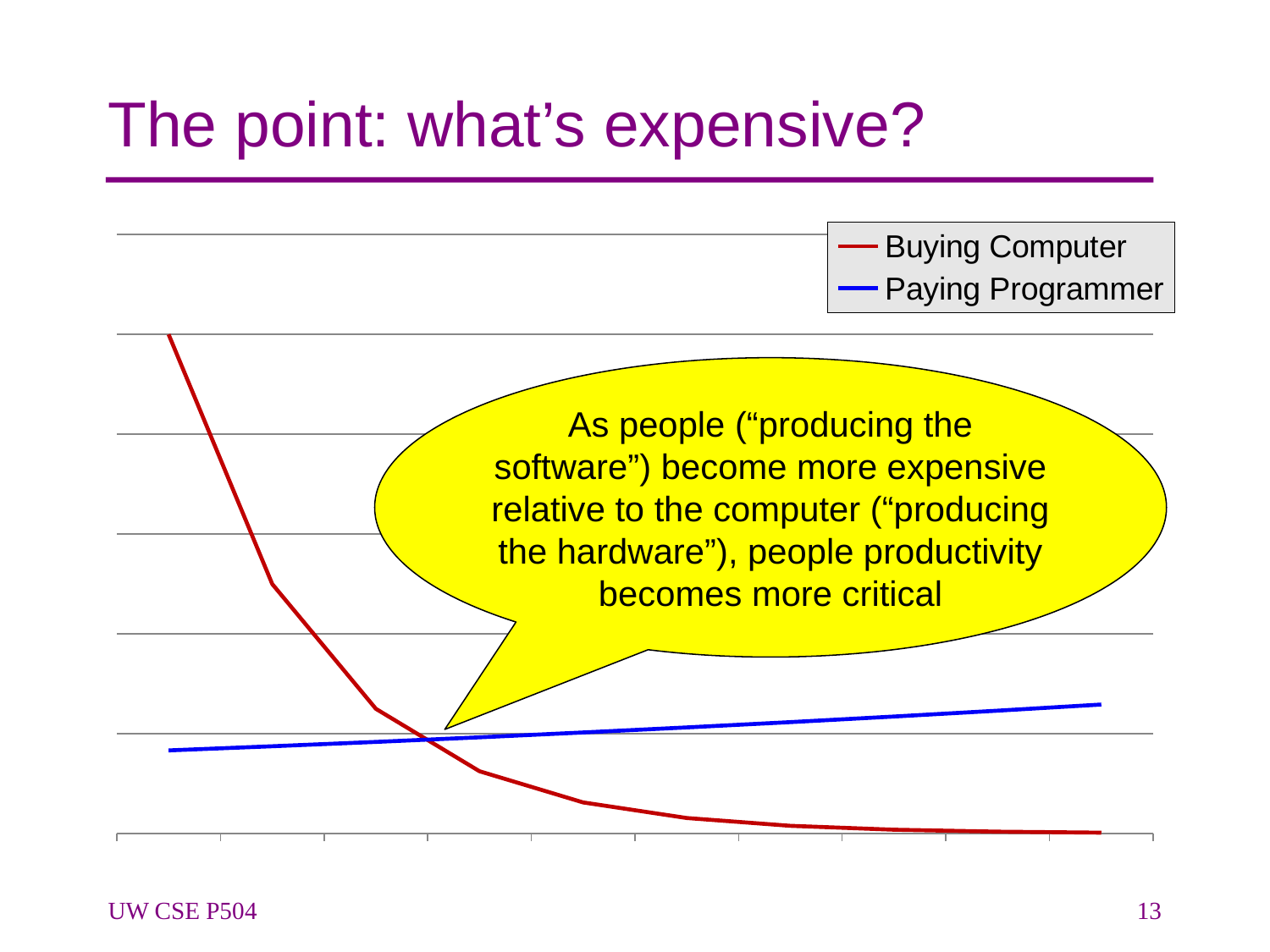
What colour is the Buying Computer line? Red At the right end of the chart, which series is higher: Buying Computer or Paying Programmer? Paying Programmer At the left end of the chart, which series is higher: Buying Computer or Paying Programmer? Buying Computer Which series ends at the lowest point on the chart? Buying Computer Which series starts at the highest point on the chart? Buying Computer What are the two series named in the legend? Buying Computer and Paying Programmer Does the Paying Programmer line rise or fall from left to right? Rises What kind of chart is shown on the slide? Line chart Does the Buying Computer line rise or fall from left to right? Falls How many series does the legend list? 2 Do the two lines cross each other on the chart? Yes